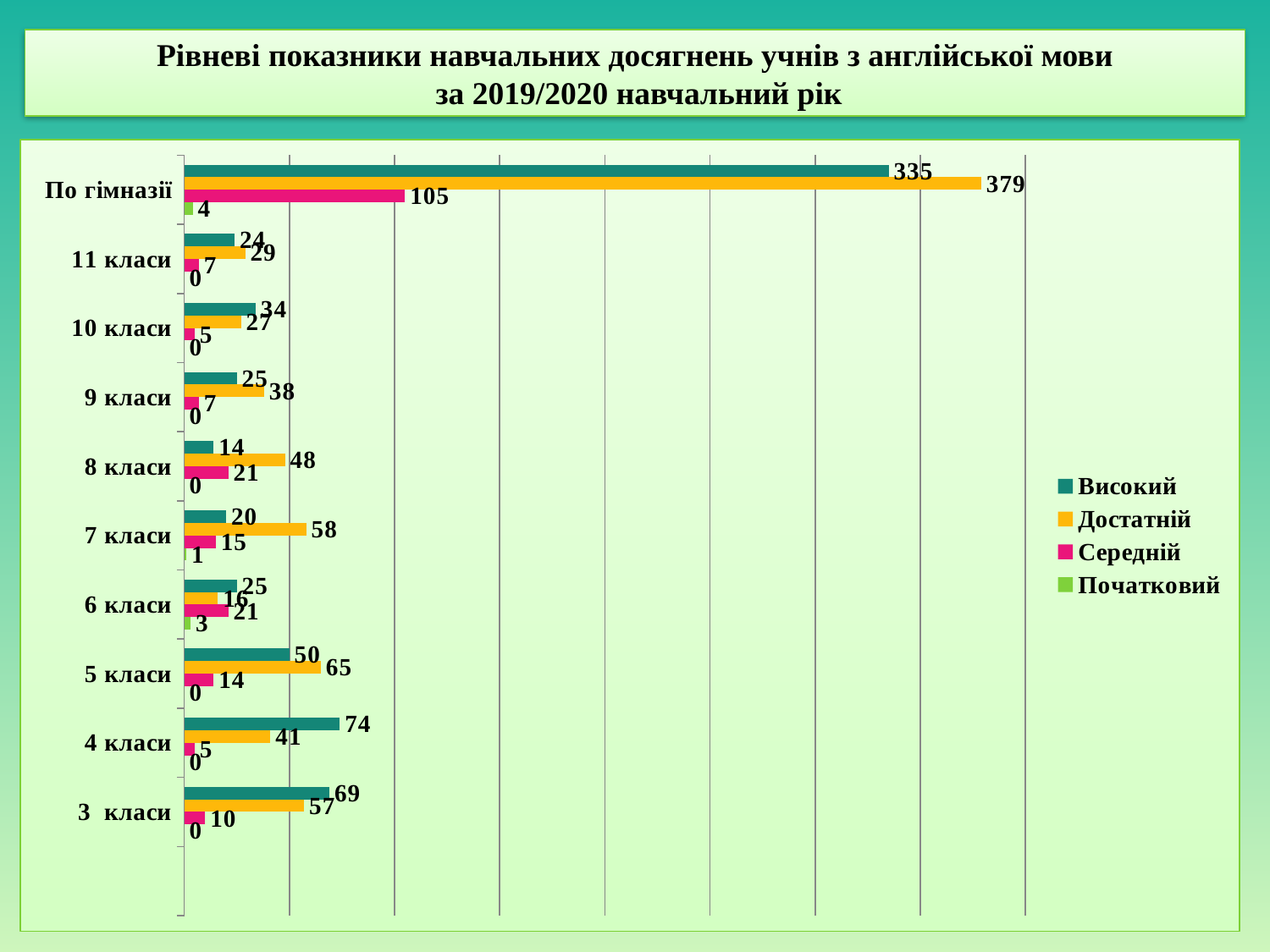
What is the value of Високий for 4 класи? 74 Which is larger for 3 класи: Високий or Достатній? Високий What is the value of Середній for 8 класи? 21 How many categories are shown on the chart? 10 What is the value of Достатній for По гімназії? 379 Which series is shown in pink on the chart? Середній What kind of chart is shown on the slide? Bar chart What is the value of Початковий for 6 класи? 3 Among the class categories (excluding По гімназії), which has the lowest Високий value? 8 класи Which category has the highest Високий value? По гімназії What is the difference between the Достатній and Високий values for 5 класи? 15 How many series does the legend list? 4